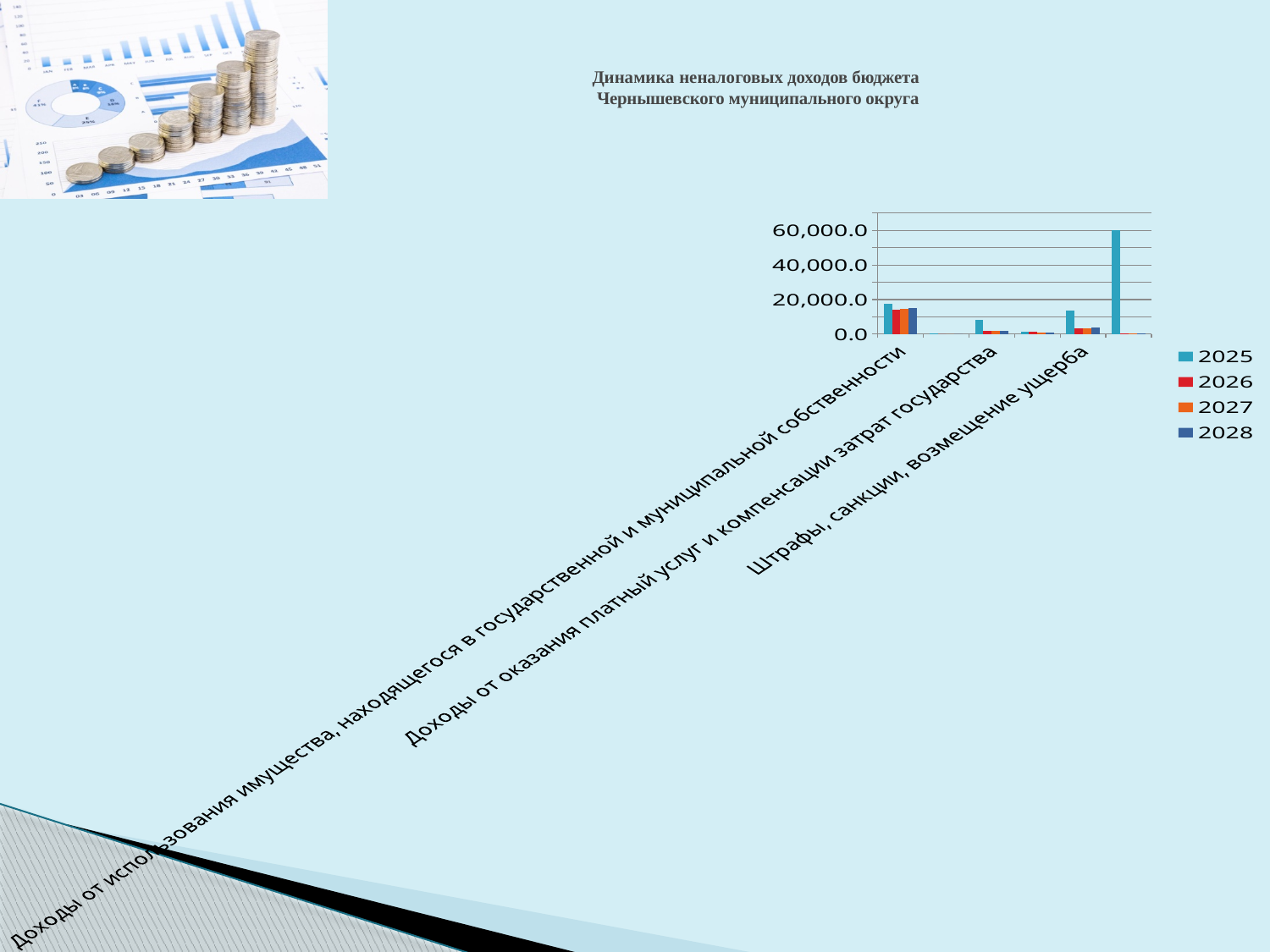
For "Доходы от оказания платный услуг и компенсации затрат государства", which is larger: the 2025 value or the 2027 value? 2025 Is the 2025 value for "Доходы от использования имущества, находящегося в государственной и муниципальной собственности" greater or less than 20,000.0? less Which years are listed in the chart legend? 2025, 2026, 2027, 2028 Is the 2025 value for "Доходы от оказания платный услуг и компенсации затрат государства" greater or less than 20,000.0? less Which is larger: the 2025 value for "Доходы от использования имущества, находящегося в государственной и муниципальной собственности" or the 2025 value for "Штрафы, санкции, возмещение ущерба"? Доходы от использования имущества, находящегося в государственной и муниципальной собственности What is the title of the chart? Динамика неналоговых доходов бюджета Чернышевского муниципального округа Is the 2025 value for "Штрафы, санкции, возмещение ущерба" greater or less than 20,000.0? less For "Штрафы, санкции, возмещение ущерба", which is larger: the 2025 value or the 2026 value? 2025 What kind of chart is shown on the slide? bar chart How many series does the chart legend list? 4 What is the highest value shown on the chart's vertical axis? 60,000.0